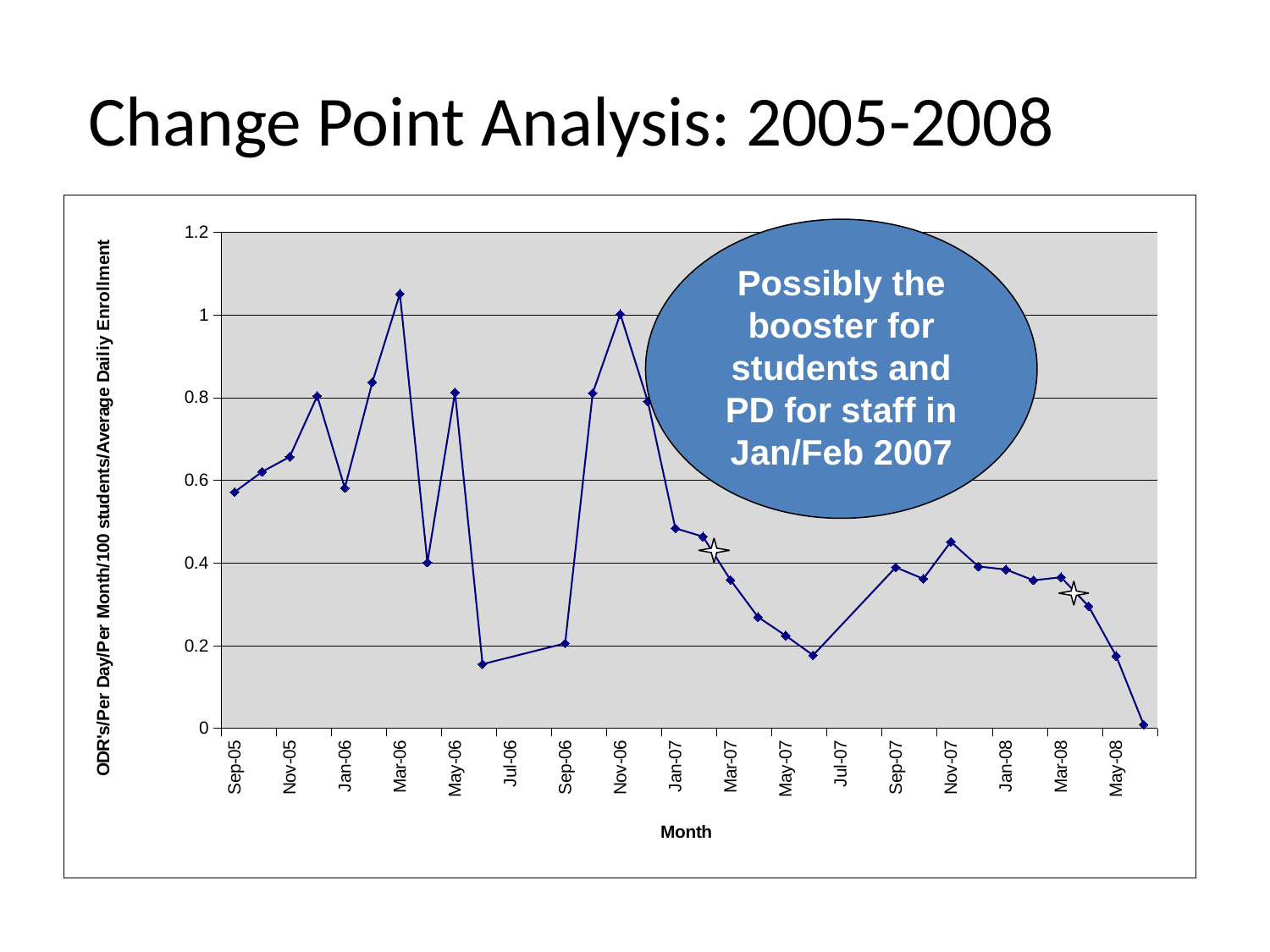
Is the value for Sep-05 greater or less than 0.6? less What does the blue callout on the chart say? Possibly the booster for students and PD for staff in Jan/Feb 2007 What is the title of the x axis? Month Is the value for Mar-07 greater or less than 0.4? less Do the values rise or fall from Nov-06 to Jun-07? fall What kind of chart is shown on the slide? line chart Which is larger, the value for Mar-06 or the value for Jan-06? Mar-06 Which month has the lowest value on the chart? Jun-08 Which month has the highest value on the chart? Mar-06 Is the value for Mar-06 greater or less than 1? greater